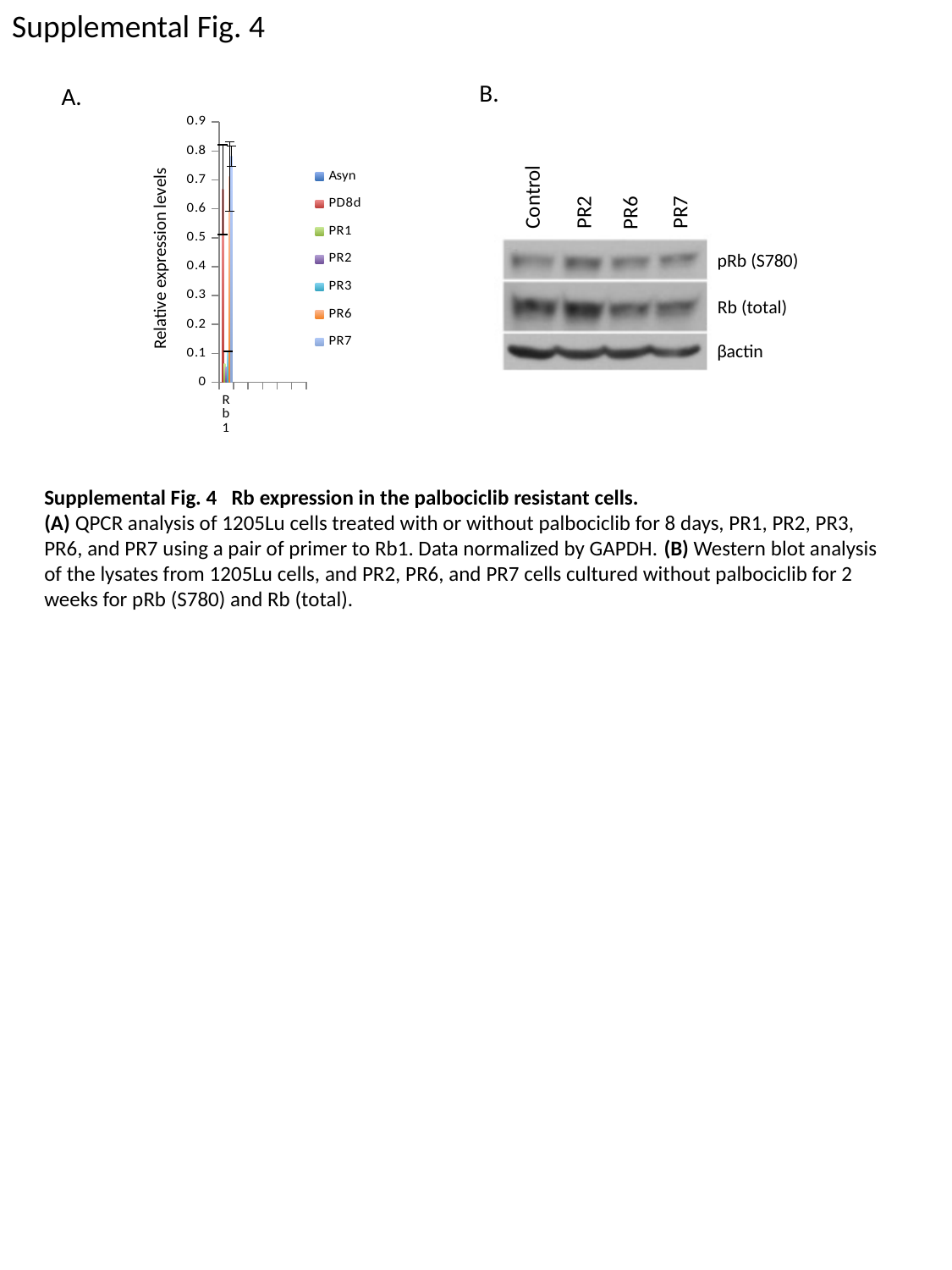
What is the y-axis label of the chart in panel A? Relative expression levels How many categories are shown on the x axis of the chart in panel A? 1 How many series does the legend of the chart in panel A list? 7 What kind of chart is shown in panel A? bar chart What is the category label on the x axis of the chart in panel A? Rb1 In the chart in panel A, is the value for Asyn greater or less than 0.5? greater